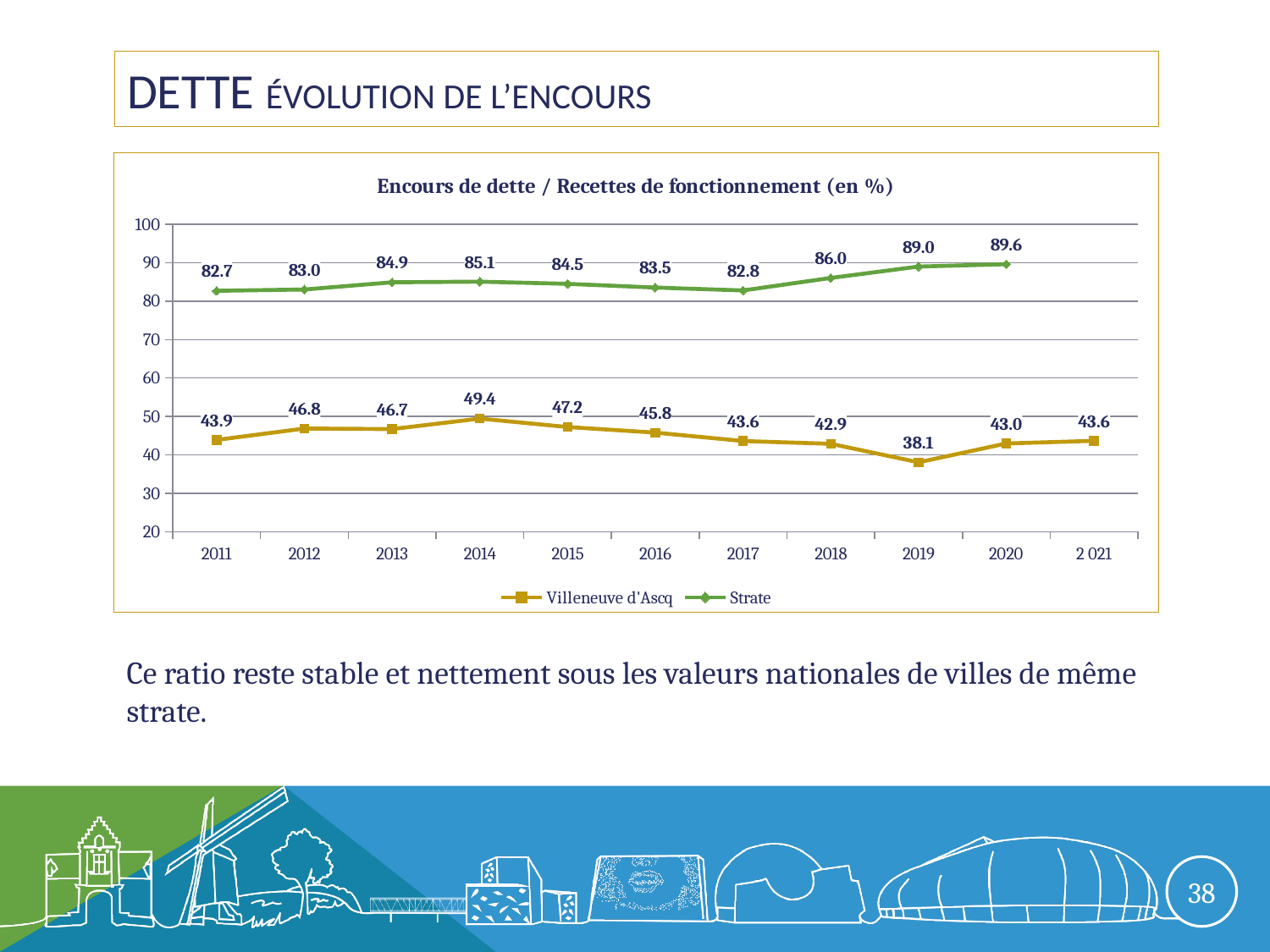
What is the value for Villeneuve d'Ascq in 2014? 49.4 How many series does the legend list? 2 What is the difference between the Strate and Villeneuve d'Ascq values in 2011? 38.8 Does the Strate series rise or fall from 2017 to 2020? rise How many years are shown on the x axis? 11 What is the value for Strate in 2017? 82.8 What is the title of the chart? Encours de dette / Recettes de fonctionnement (en %) Is the value for Villeneuve d'Ascq in 2019 greater or less than 40? less Which series has the larger value in 2019, Villeneuve d'Ascq or Strate? Strate In which year is the Villeneuve d'Ascq value lowest? 2019 In which year is the Strate value highest? 2020 What kind of chart is shown on the slide? line chart